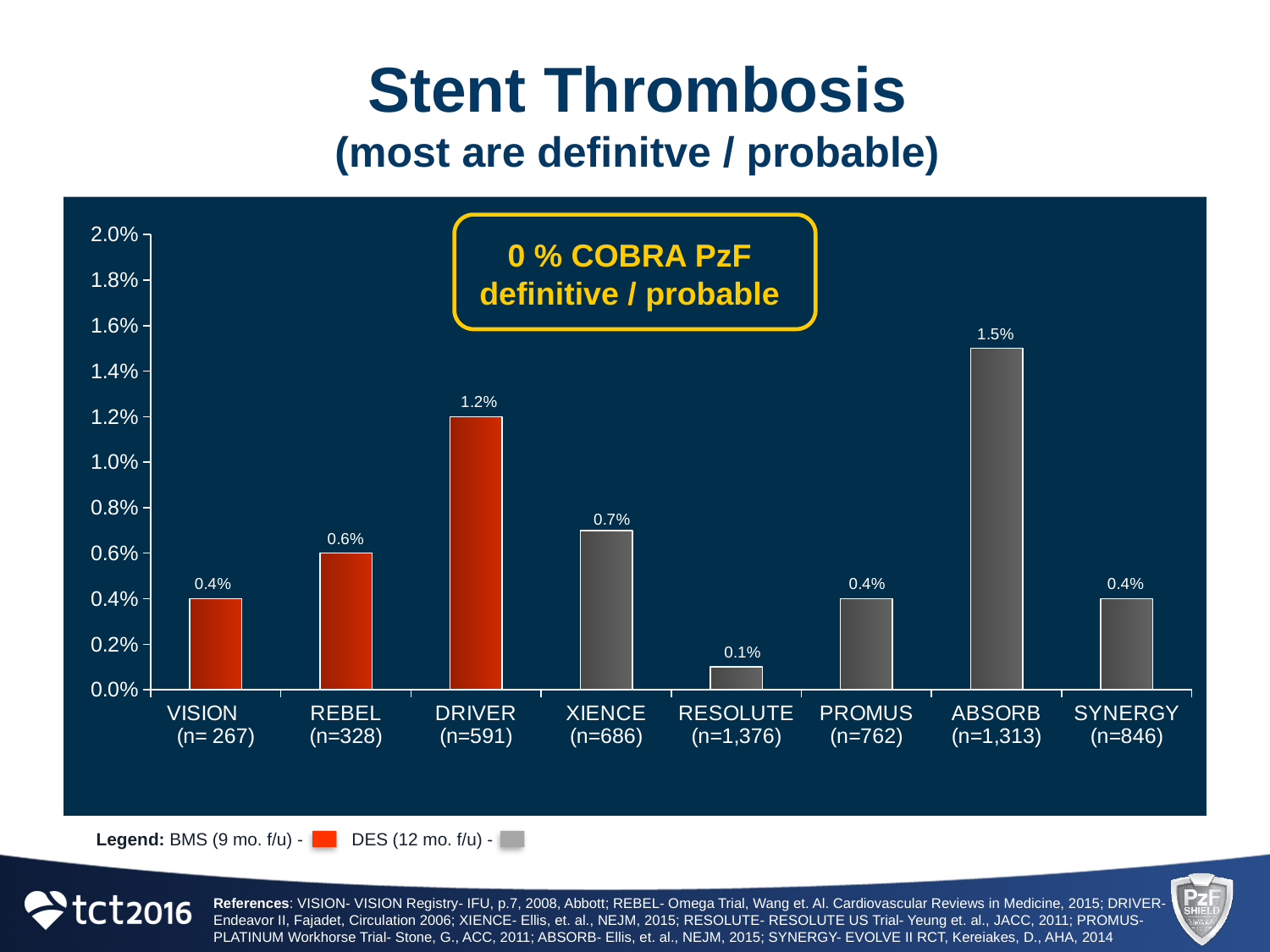
What is the stent thrombosis rate for RESOLUTE? 0.1% Which has a higher stent thrombosis rate, REBEL or XIENCE? XIENCE Is the value for ABSORB greater or less than 1.0%? greater How many stents are shown on the x axis of the chart? 8 What is the stent thrombosis rate for XIENCE? 0.7% What is the stent thrombosis rate for DRIVER? 1.2% What is the sample size (n) shown for RESOLUTE? 1,376 What is the difference between the stent thrombosis rates of ABSORB and DRIVER? 0.3% Which stent has the highest stent thrombosis rate? ABSORB What kind of chart is shown on the slide? bar chart How many bars are coloured red (BMS) in the chart? 3 Which stent has the lowest stent thrombosis rate? RESOLUTE